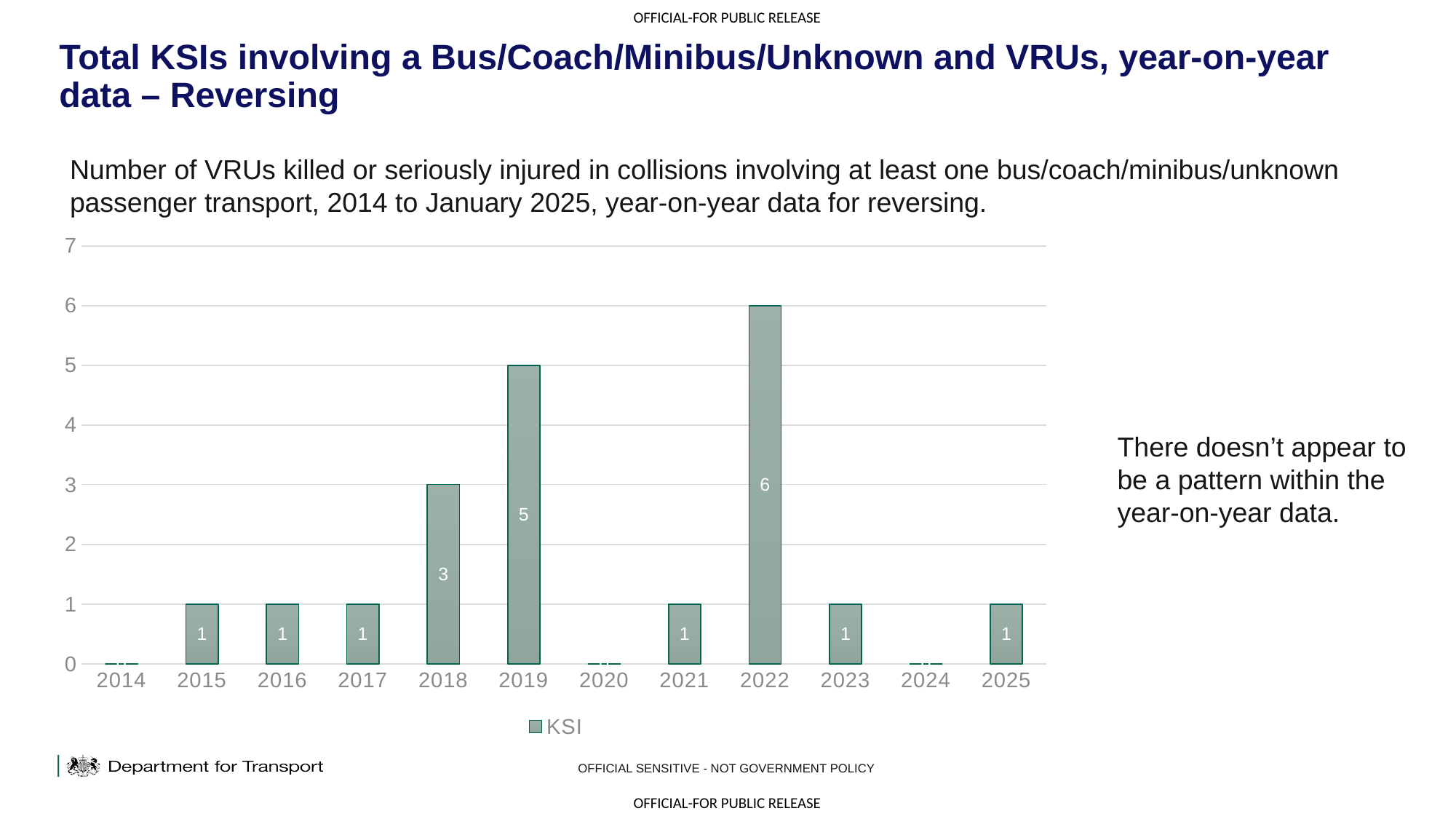
What is the difference between the KSI values for 2019 and 2018? 2 How many years are shown on the x axis? 12 What is the KSI value for 2022? 6 What is the KSI value for 2019? 5 How many series does the legend list? 1 Is the KSI value for 2022 greater or less than 5? greater What kind of chart is shown on the slide? Bar chart Which year has the highest KSI value? 2022 What is the KSI value for 2018? 3 Which is larger, the KSI value for 2018 or for 2021? 2018 What is the KSI value for 2015? 1 What is the difference between the KSI values for 2022 and 2019? 1